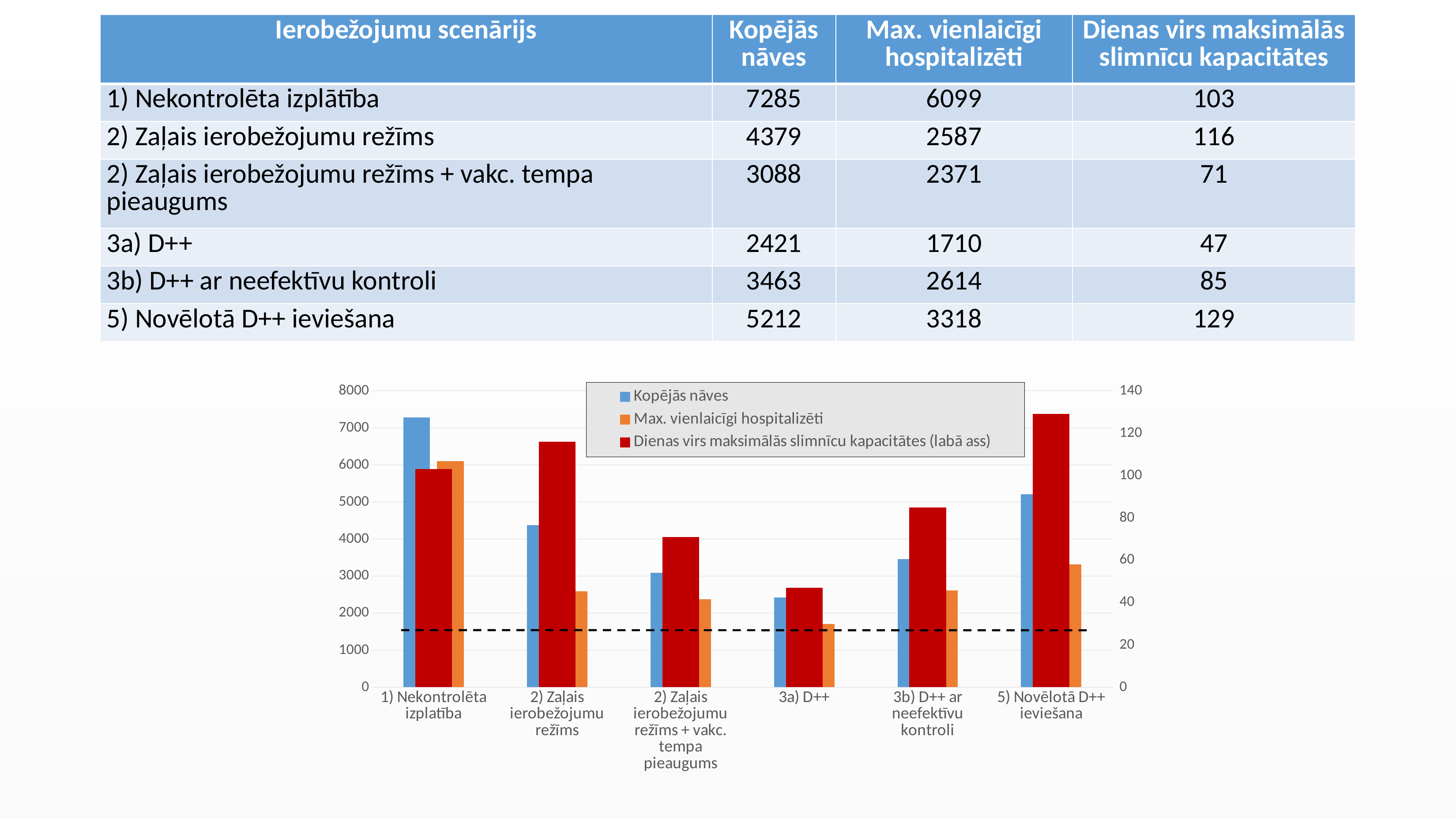
Which scenario has the lowest value of Dienas virs maksimālās slimnīcu kapacitātes? 3a) D++ How many scenarios (categories) are plotted on the x axis of the chart? 6 How many series does the chart legend list? 3 What kind of chart is shown on the slide? bar chart What is the value of Kopējās nāves for the scenario 1) Nekontrolēta izplātība? 7285 What is the difference in Kopējās nāves between 1) Nekontrolēta izplātība and 2) Zaļais ierobežojumu režīms? 2906 Is the Kopējās nāves value for 5) Novēlotā D++ ieviešana greater or less than 5000? greater What is the value of Max. vienlaicīgi hospitalizēti for the scenario 3a) D++? 1710 Which is larger: Kopējās nāves for 5) Novēlotā D++ ieviešana or for 3b) D++ ar neefektīvu kontroli? 5) Novēlotā D++ ieviešana What is the value of Dienas virs maksimālās slimnīcu kapacitātes for the scenario 5) Novēlotā D++ ieviešana? 129 Which scenario has the highest value of Kopējās nāves? 1) Nekontrolēta izplātība Which series in the chart is plotted on the right axis (labā ass)? Dienas virs maksimālās slimnīcu kapacitātes